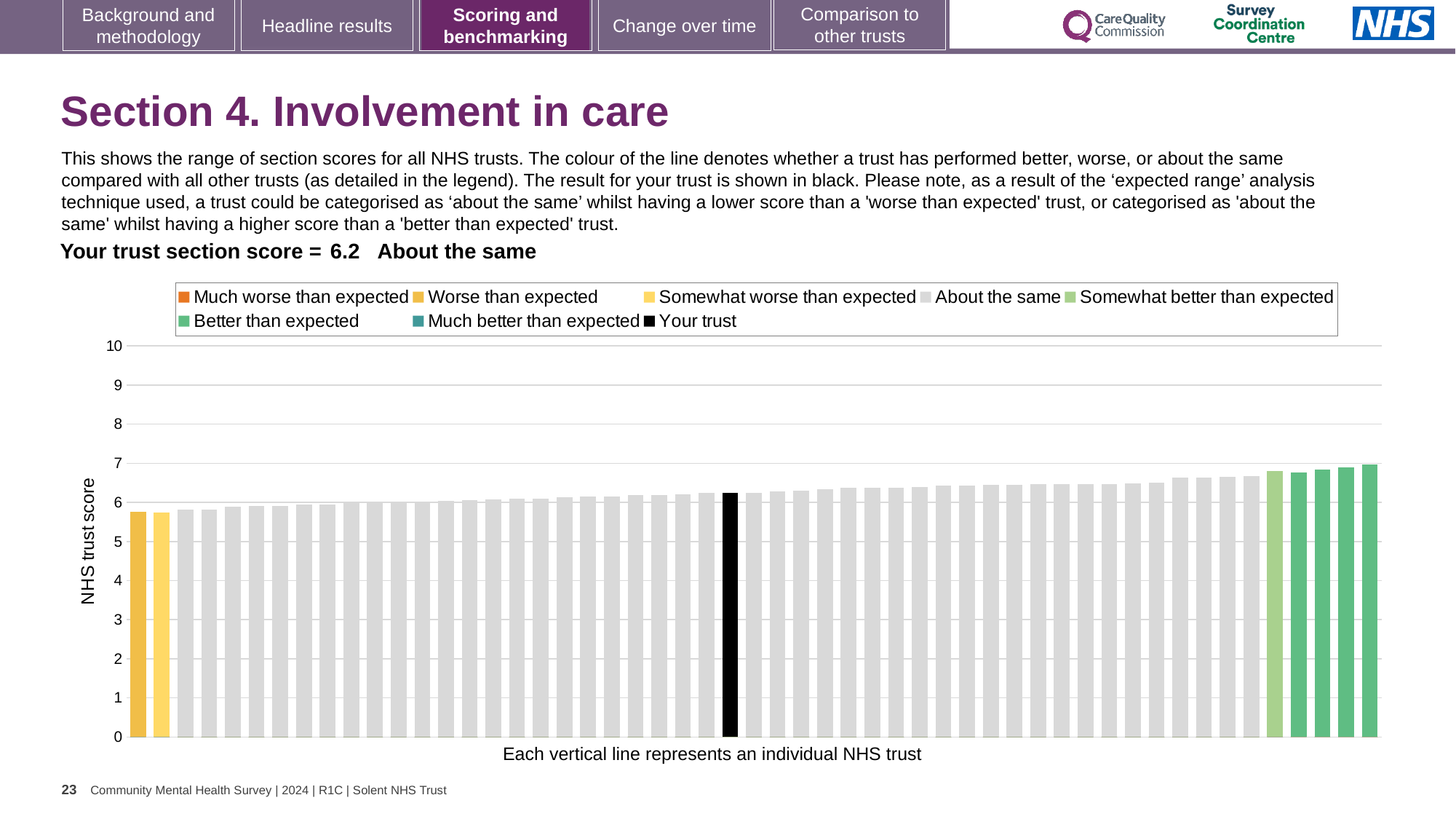
Which is larger, the leftmost bar or the rightmost bar? the rightmost bar What is the label on the vertical axis of the chart? NHS trust score Is the value for the leftmost bar greater or less than 6? less How many bars are coloured yellow (worse than expected)? 2 How many bars are coloured dark green (better than expected)? 4 Is the value for the rightmost bar greater or less than 6? greater Do the bar values rise or fall from left to right along the x axis? rise Is the value for your trust greater or less than 7? less What is the section score for your trust shown on the slide? 6.2 How many entries does the chart legend list? 8 What colour is the bar representing your trust? black What kind of chart is shown on the slide? bar chart